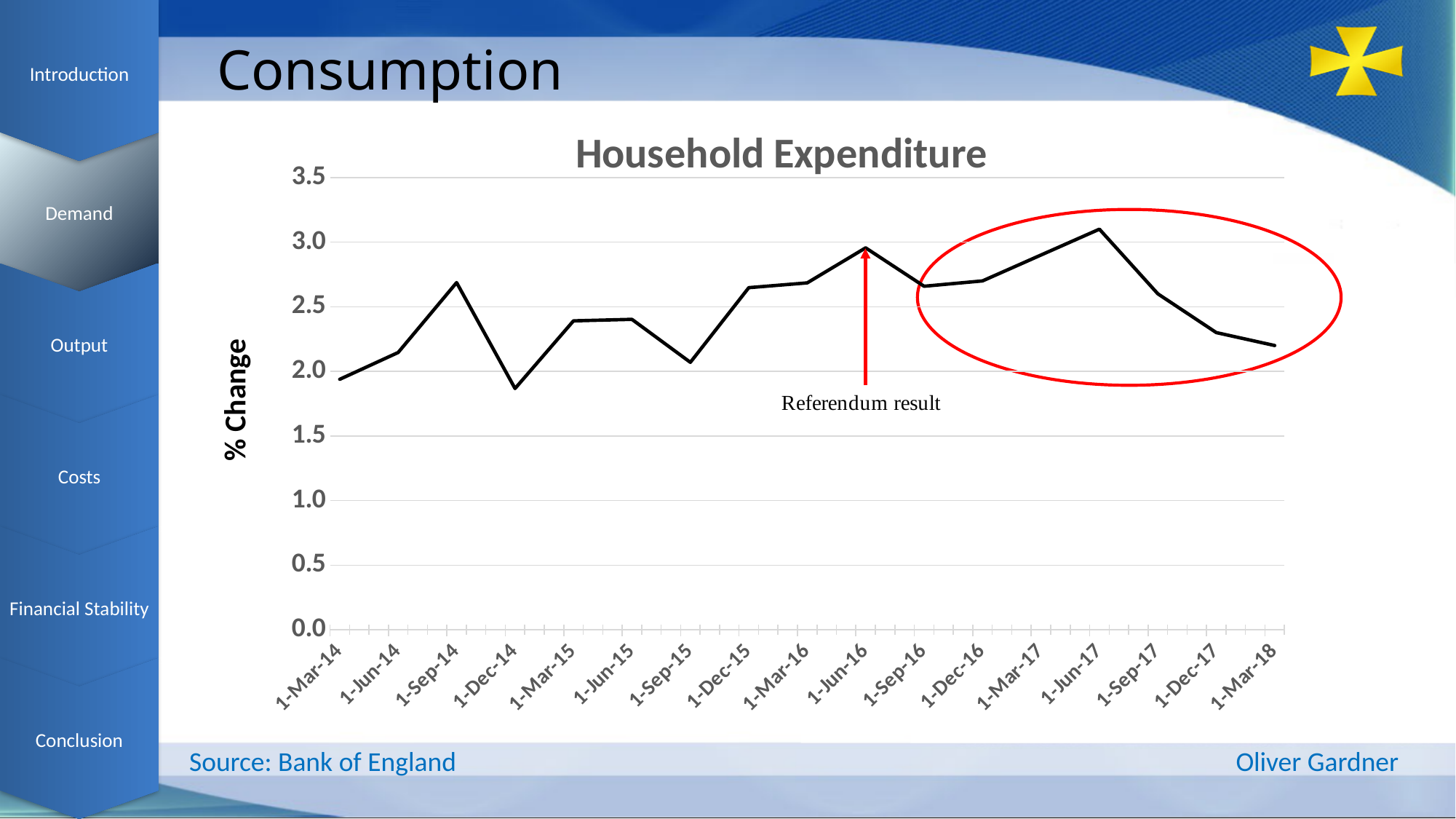
At which date does the line reach its highest value? 1-Jun-17 How many dates are labelled along the x axis of the chart? 17 Which has the larger value, 1-Jun-17 or 1-Mar-18? 1-Jun-17 Is the value for 1-Sep-14 greater or less than 2.5? greater What is the title of the chart? Household Expenditure Which has the larger value, 1-Sep-14 or 1-Dec-14? 1-Sep-14 Is the value for 1-Jun-17 greater or less than 3.0? greater Does the line rise or fall between 1-Jun-17 and 1-Mar-18? fall Is the value for 1-Mar-18 greater or less than 2.0? greater What kind of chart is shown on the slide? line chart What is the label on the vertical axis of the chart? % Change